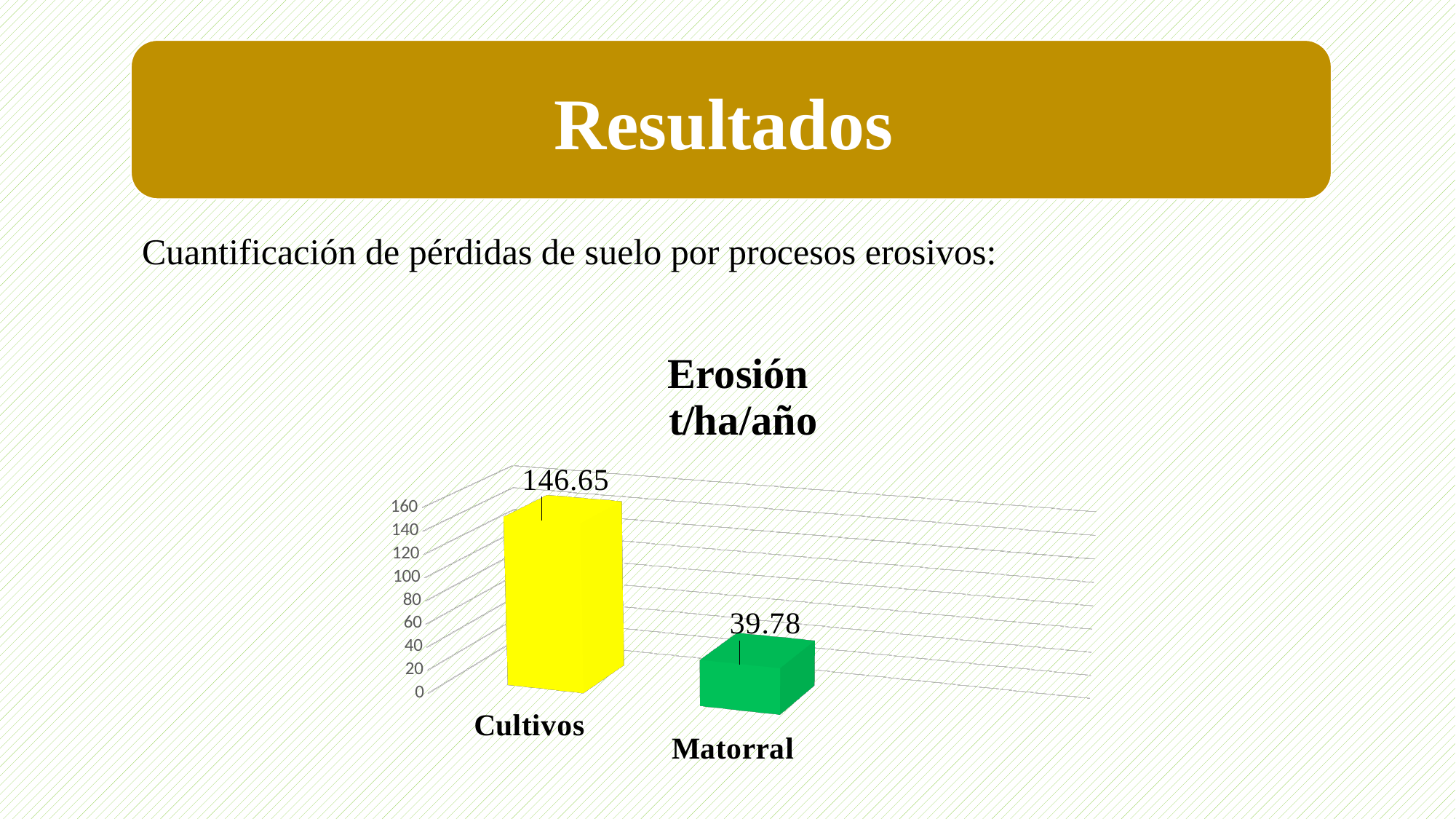
Which category has the highest value? Cultivos What colour is the bar for Matorral? green What is the value for Matorral? 39.78 What kind of chart is shown on the slide? bar chart Is the value for Matorral greater or less than 60? less Which category has the lowest value? Matorral Which is larger, the value for Cultivos or the value for Matorral? Cultivos What is the value for Cultivos? 146.65 Is the value for Cultivos greater or less than 120? greater How many categories are shown in the chart? 2 What is the title of the chart? Erosión t/ha/año What is the difference between the values for Cultivos and Matorral? 106.87